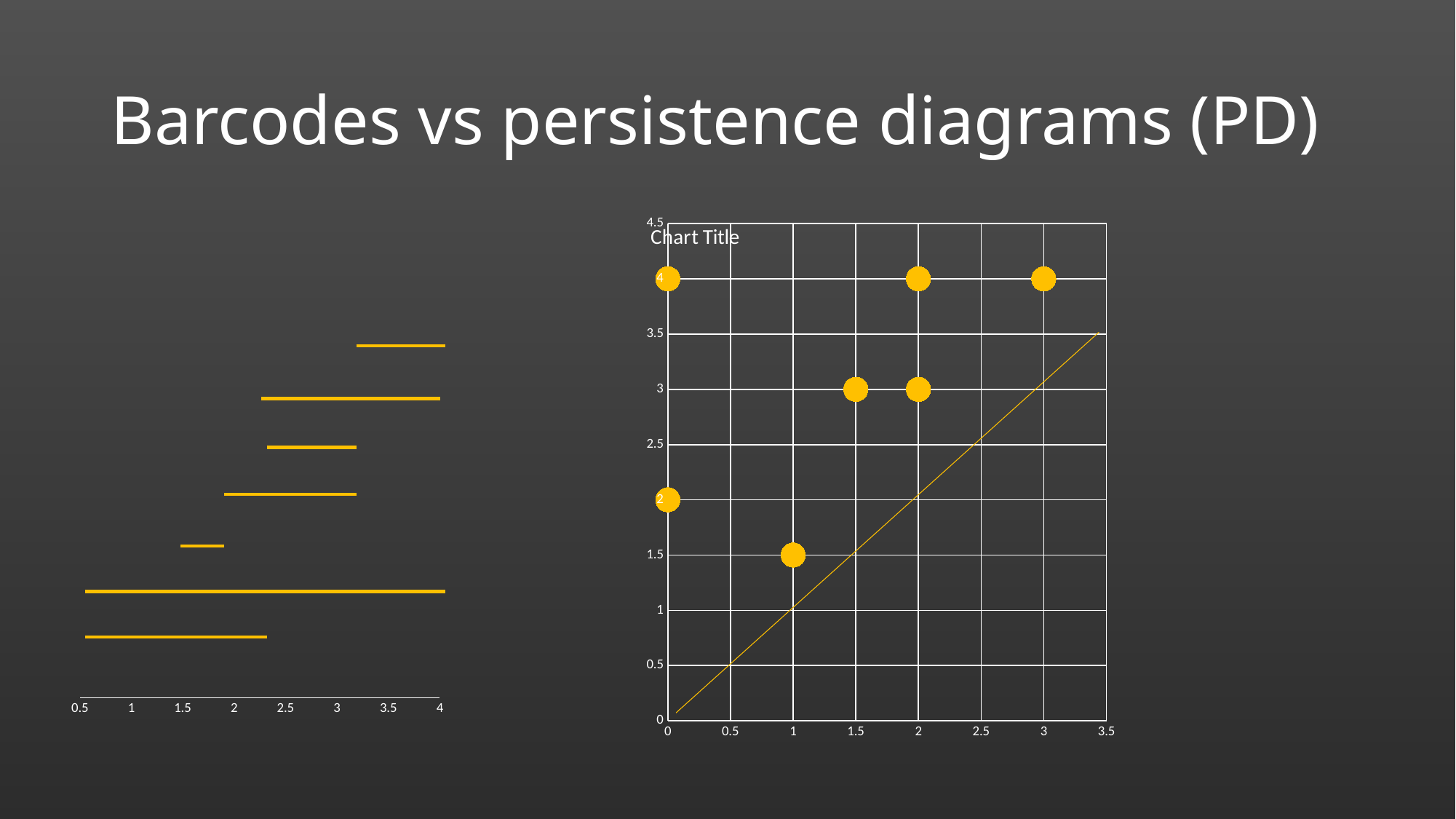
In the chart on the right, what is the y value of the point at x = 1? 1.5 What kind of chart is the chart on the right of the slide? scatter chart In the chart on the left, is the right end of the longest bar greater or less than 3.5? greater In the chart on the right, what is the x value of the point farthest to the right? 3 In the chart on the right, how many data points are plotted? 7 In the chart on the right, how many points lie at x = 0? 2 What kind of chart is the chart on the left of the slide? bar chart In the chart on the left, how many bars are drawn? 7 What is the title of the chart on the right of the slide? Chart Title In the chart on the right, what is the largest tick value shown on the x axis? 3.5 In the chart on the right, what is the lowest y value among the plotted points? 1.5